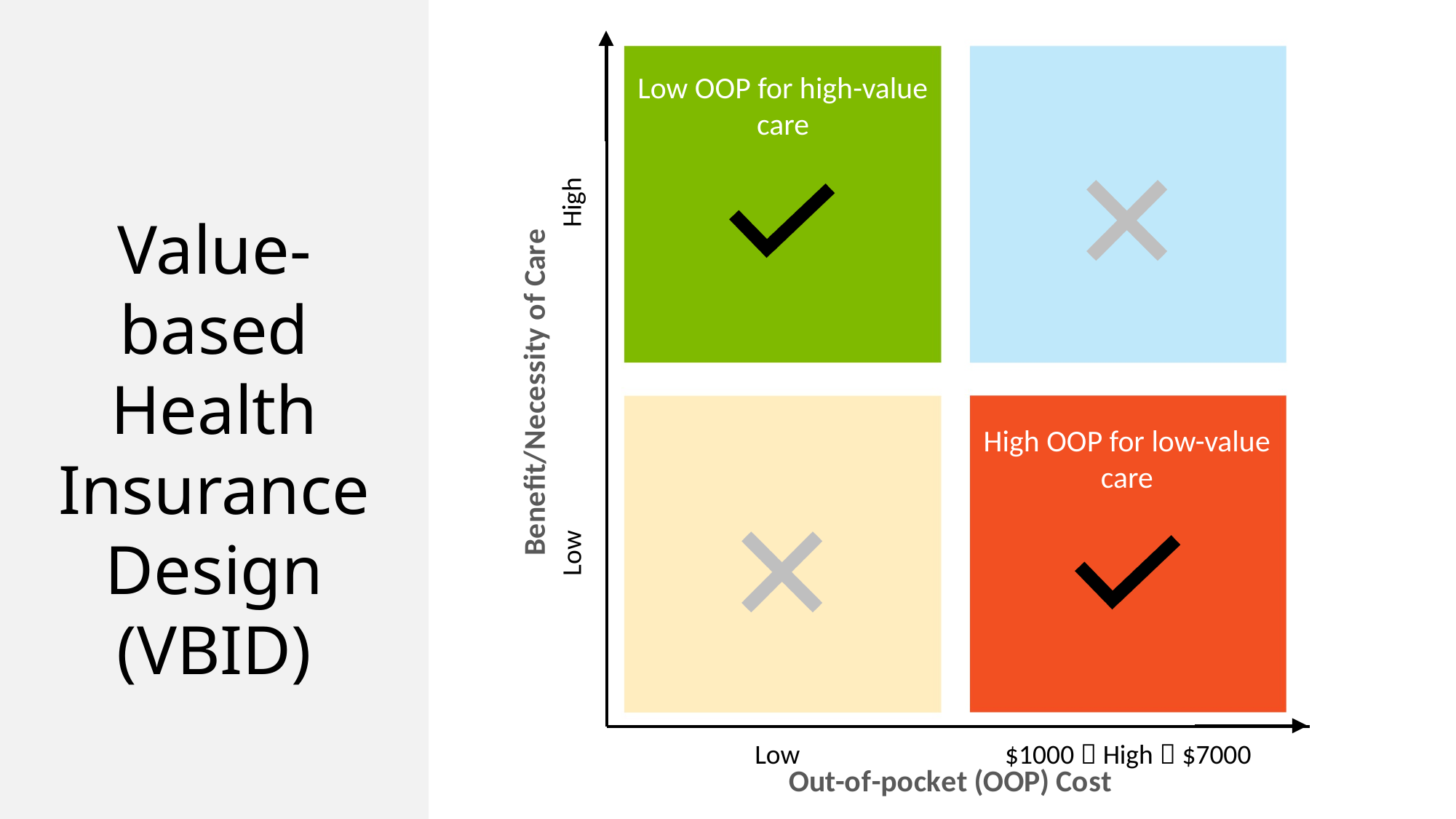
What is the label on the horizontal axis of the matrix? Out-of-pocket (OOP) Cost How many quadrants does the matrix contain? 4 What text appears in the red quadrant (low benefit, high OOP cost)? High OOP for low-value care What kind of chart is shown on the slide? A 2x2 matrix (quadrant diagram) How many quadrants are marked with an X? 2 What text appears in the green quadrant (high benefit, low OOP cost)? Low OOP for high-value care How many quadrants are marked with a checkmark? 2 What is the label on the vertical axis of the matrix? Benefit/Necessity of Care